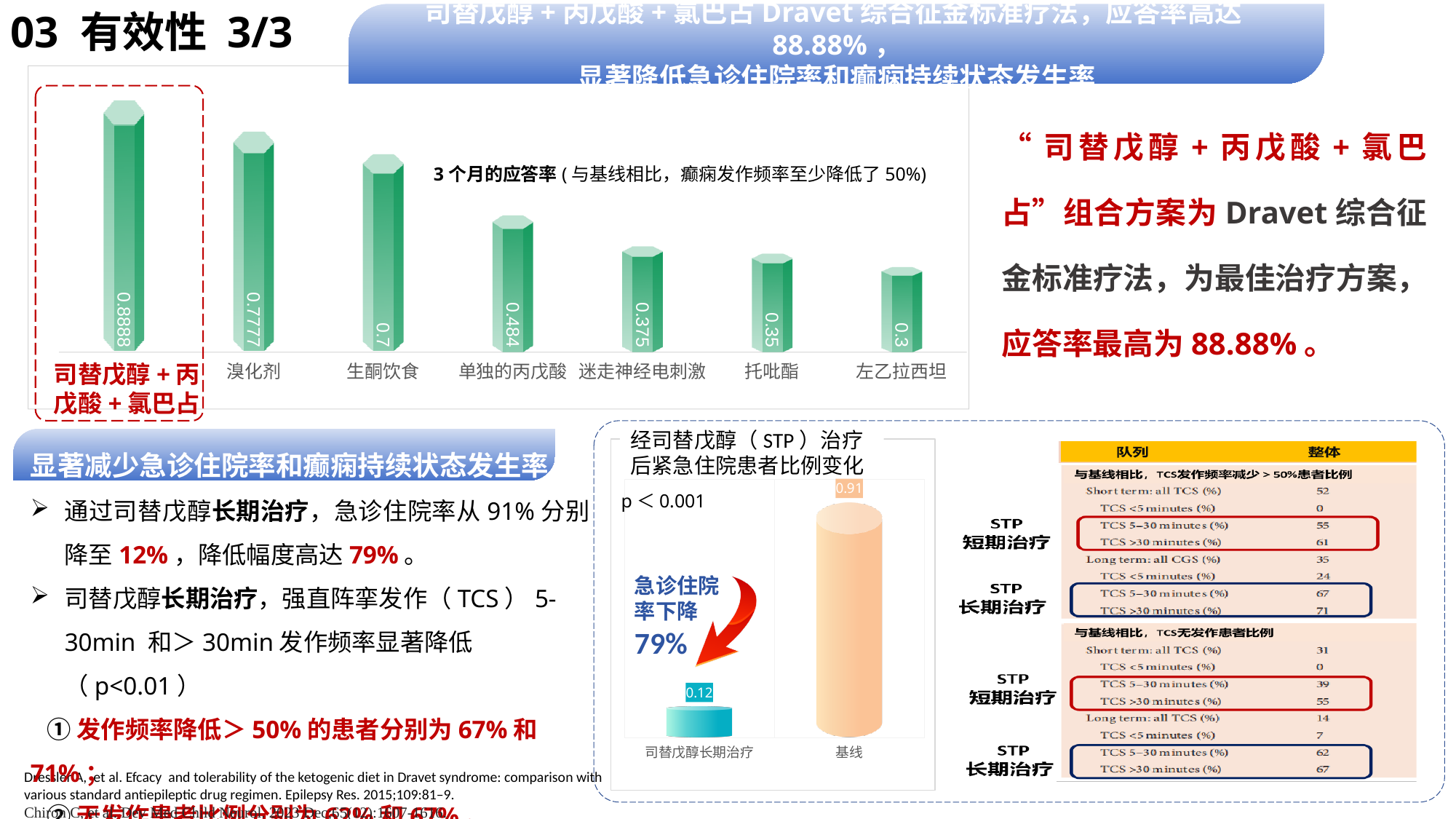
In the top bar chart of 3-month response rates, what is the value for 生酮饮食? 0.7 In the bottom chart of emergency hospitalization proportion after STP treatment, what is the difference between 基线 and 司替戊醇长期治疗? 0.79 In the top bar chart of 3-month response rates, do the values rise or fall from left to right? fall In the top bar chart of 3-month response rates, which category has the lowest value? 左乙拉西坦 In the top bar chart of 3-month response rates, what is the value for 迷走神经电刺激? 0.375 What kind of chart is the top chart showing 3-month response rates? bar chart In the top bar chart of 3-month response rates, what is the difference between 司替戊醇+丙戊酸+氯巴占 and 溴化剂? 0.1111 In the top bar chart of 3-month response rates, which is larger: 单独的丙戊酸 or 托吡酯? 单独的丙戊酸 In the top bar chart of 3-month response rates, which category has the highest value? 司替戊醇+丙戊酸+氯巴占 In the bottom chart of emergency hospitalization proportion after STP treatment, what is the value for 基线? 0.91 In the bottom chart of emergency hospitalization proportion after STP treatment, what is the value for 司替戊醇长期治疗? 0.12 How many categories are shown in the top bar chart of 3-month response rates? 7